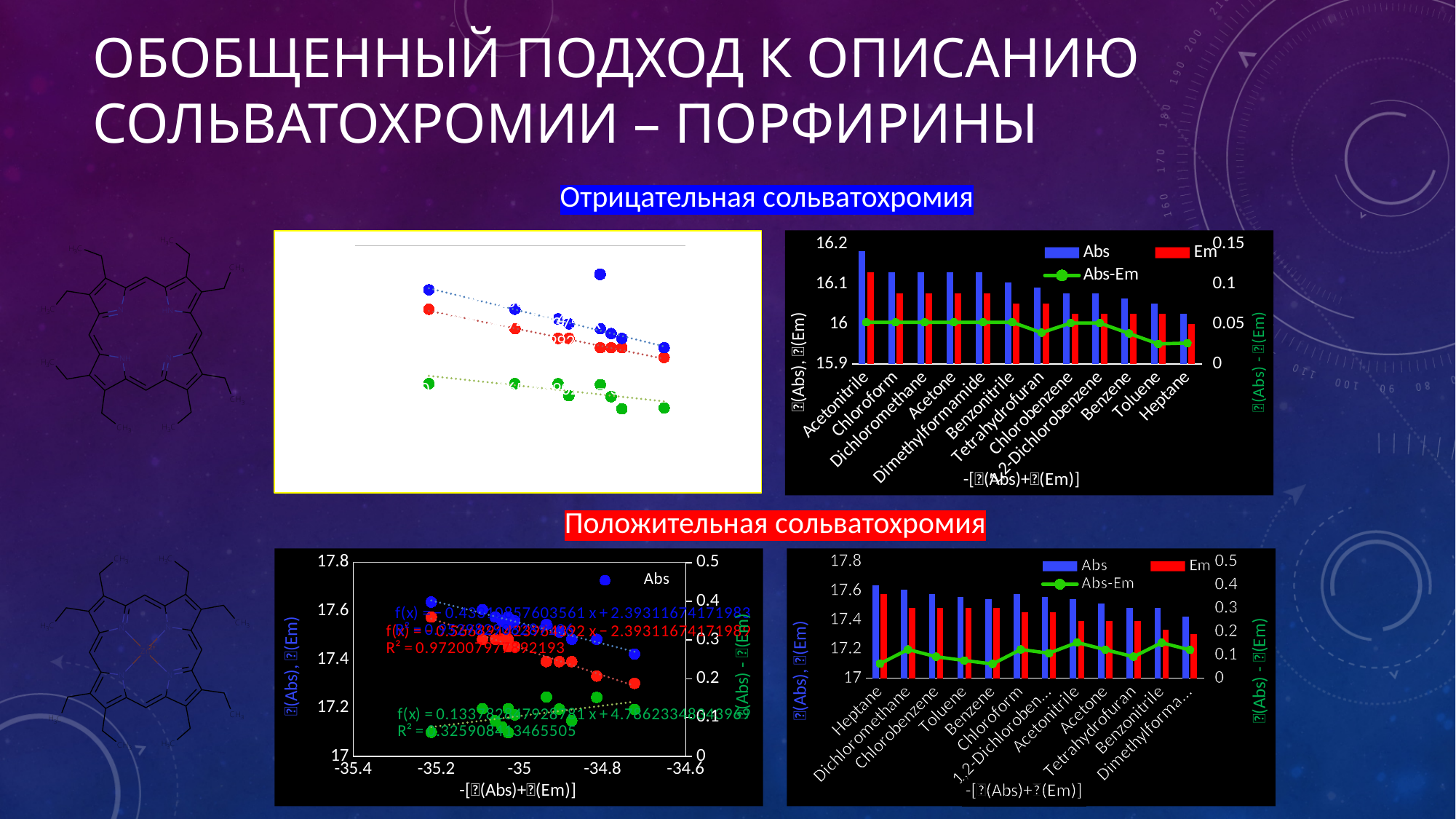
In the bottom-right bar chart under 'Положительная сольватохромия', is the Em value for Heptane greater or less than 17.4? greater How many solvent categories are shown on the x axis of the top-right bar chart under 'Отрицательная сольватохромия'? 12 In the top-right bar chart under 'Отрицательная сольватохромия', which solvent has the highest Abs bar? Acetonitrile In the bottom-left scatter chart under 'Положительная сольватохромия', what is the lowest value shown on the x axis? -35.4 In the bottom-right bar chart under 'Положительная сольватохромия', which solvent has the highest Abs bar? Heptane In the top-right bar chart under 'Отрицательная сольватохромия', is the Abs value for Heptane greater or less than 16.1? less How many series does the legend list in the top-right bar chart under 'Отрицательная сольватохромия'? 3 What kind of chart is the bottom-left chart under 'Положительная сольватохромия'? scatter chart How many solvent categories are shown on the x axis of the bottom-right bar chart under 'Положительная сольватохромия'? 12 In the bottom-left scatter chart under 'Положительная сольватохромия', do the blue Abs points rise or fall as the x value increases? fall In the top-right bar chart under 'Отрицательная сольватохромия', does the Abs-Em line overall rise or fall from Acetonitrile to Heptane? fall In the top-right bar chart under 'Отрицательная сольватохромия', is the Em value for Acetonitrile greater or less than 16.1? greater